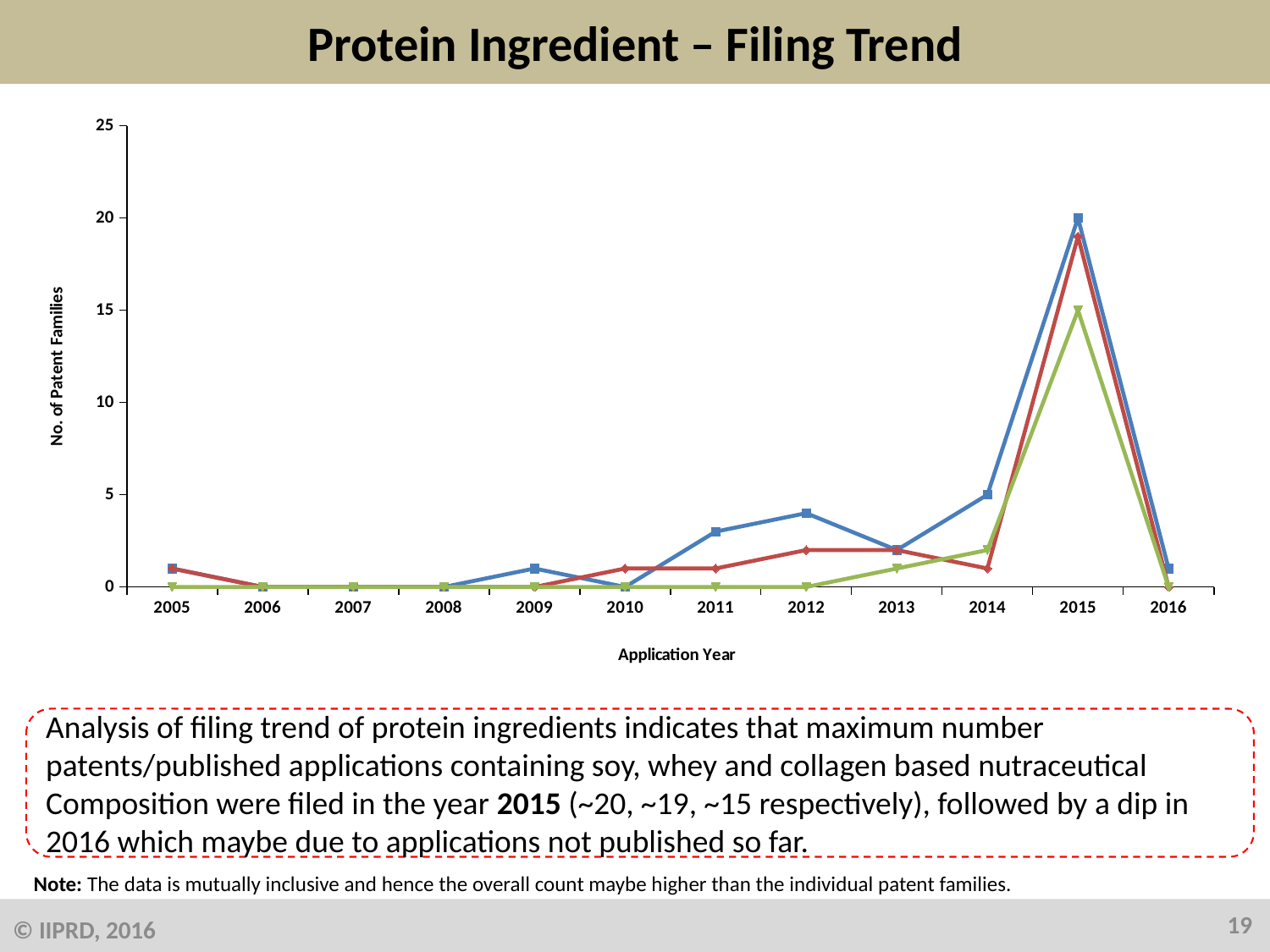
Is the value of the green line in 2014 greater or less than 5? less In 2015, which line has the larger value, the blue line or the green line? blue line How many application years are plotted along the x axis? 12 What is the difference between the blue line and the green line in 2015? 5 What is the value of the green line in 2015? 15 Do the values of the lines rise or fall from 2015 to 2016? fall What kind of chart is shown on the slide? line chart In which year does the blue line reach its highest value? 2015 What is the value of the blue line in 2014? 5 Is the value of the red line in 2015 greater or less than 15? greater What is the value of the blue line in 2015? 20 How many lines are plotted on the chart? 3